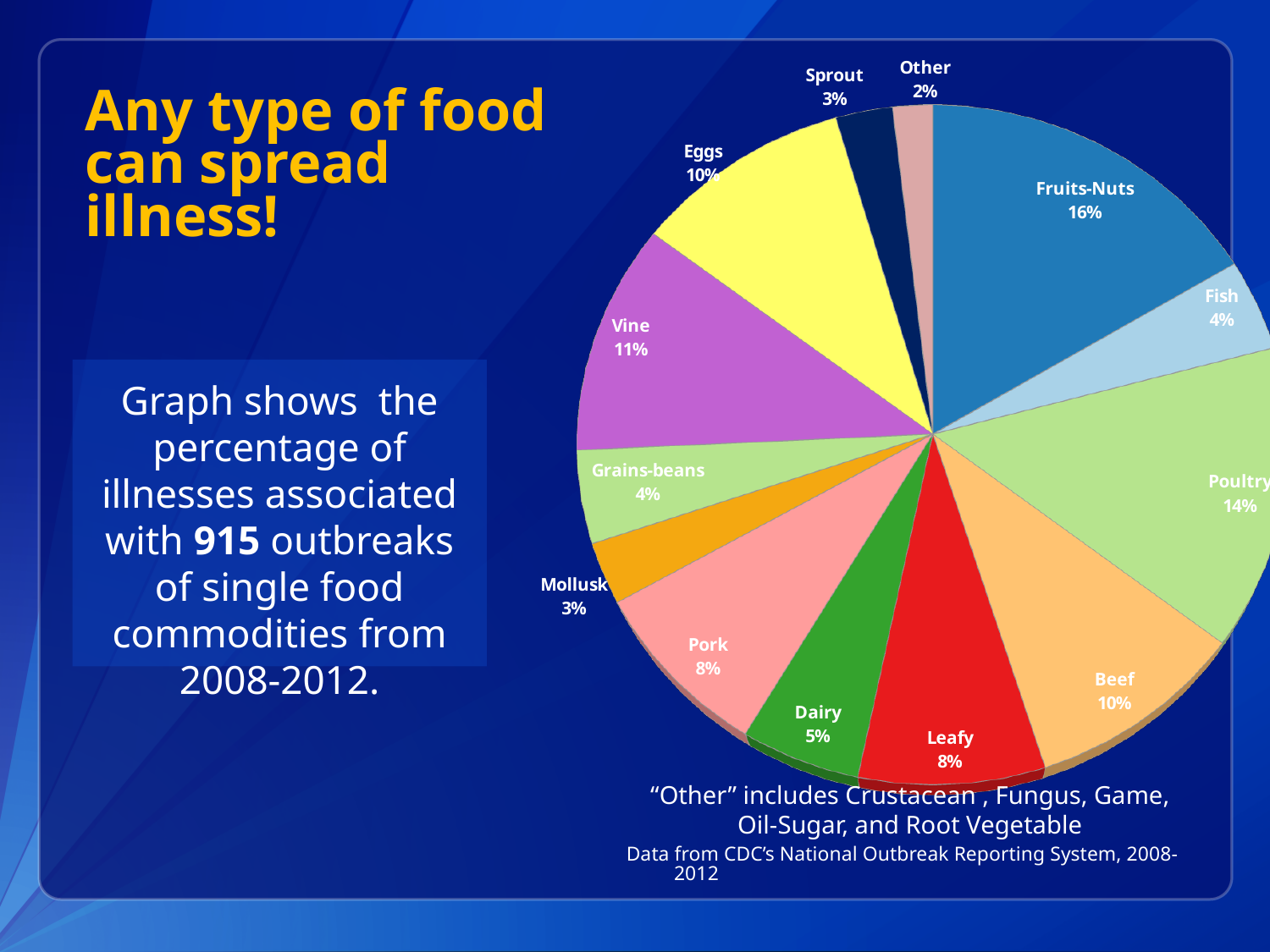
What percentage of illnesses is associated with Fruits-Nuts? 16% How many food categories are shown in the pie chart? 13 What percentage is shown for Mollusk? 3% According to the slide, what does the "Other" category include? Crustacean, Fungus, Game, Oil-Sugar, and Root Vegetable Which food category has the smallest share of the pie? Other Which food category has the largest share of the pie? Fruits-Nuts What is the combined percentage of Pork and Leafy? 16% Which has a larger share, Eggs or Dairy? Eggs What is the difference in percentage points between Fruits-Nuts and Beef? 6 What percentage is shown for Poultry? 14% What percentage is shown for Vine? 11% What kind of chart is shown on the slide? Pie chart